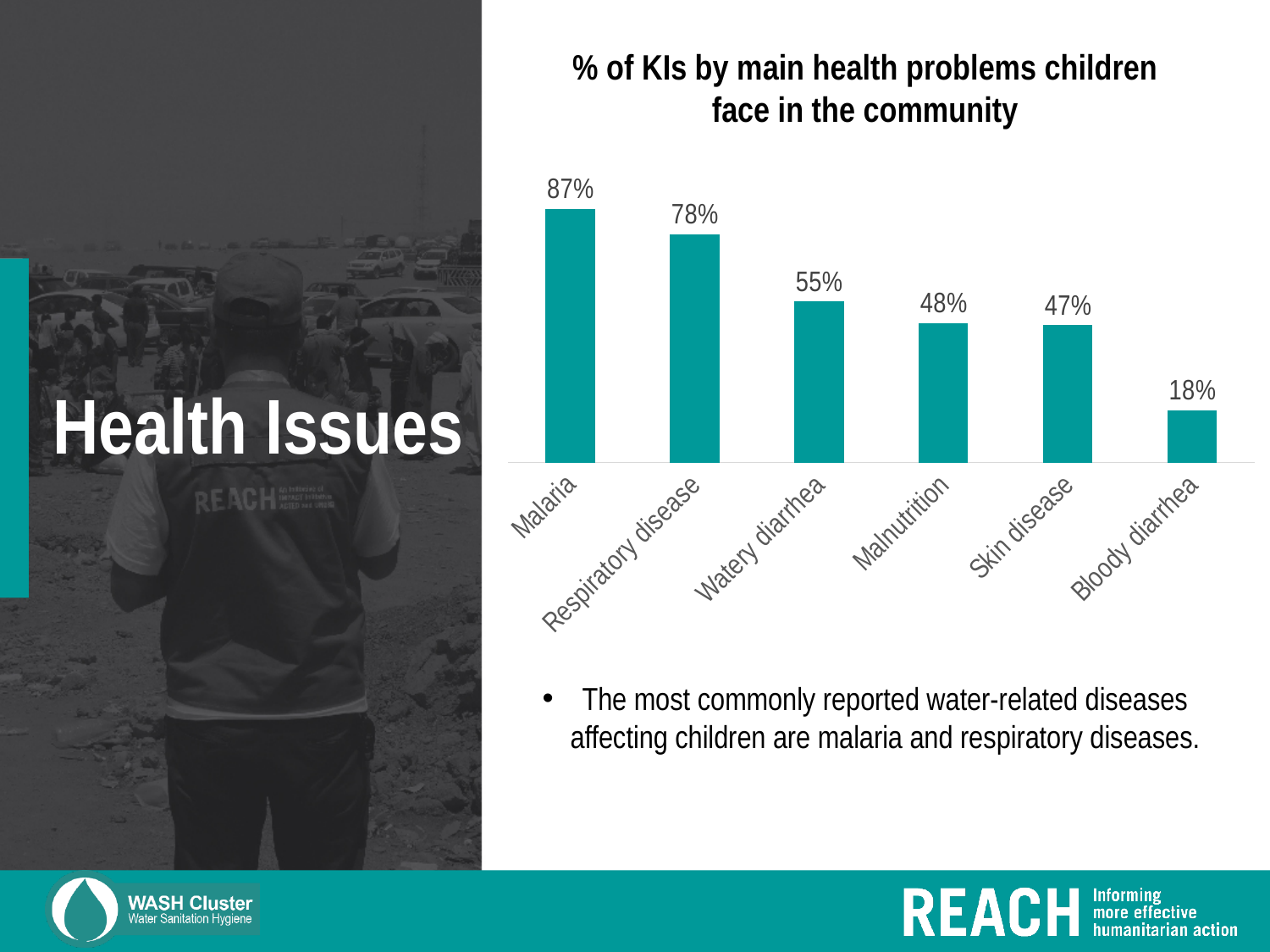
Which health problem has the lowest percentage of KIs? Bloody diarrhea Which has a higher value, malnutrition or skin disease? Malnutrition What is the difference in percentage points between malaria and respiratory disease? 9 What is the value shown for respiratory disease? 78% What percentage of KIs reported malaria as a main health problem children face? 87% What is the value for bloody diarrhea? 18% What is the difference in percentage points between watery diarrhea and bloody diarrhea? 37 What type of chart is used on this slide? Bar chart What percentage is shown for watery diarrhea? 55% What is the title of the chart? % of KIs by main health problems children face in the community Which health problem has the highest percentage of KIs? Malaria How many health problem categories are shown in the chart? 6